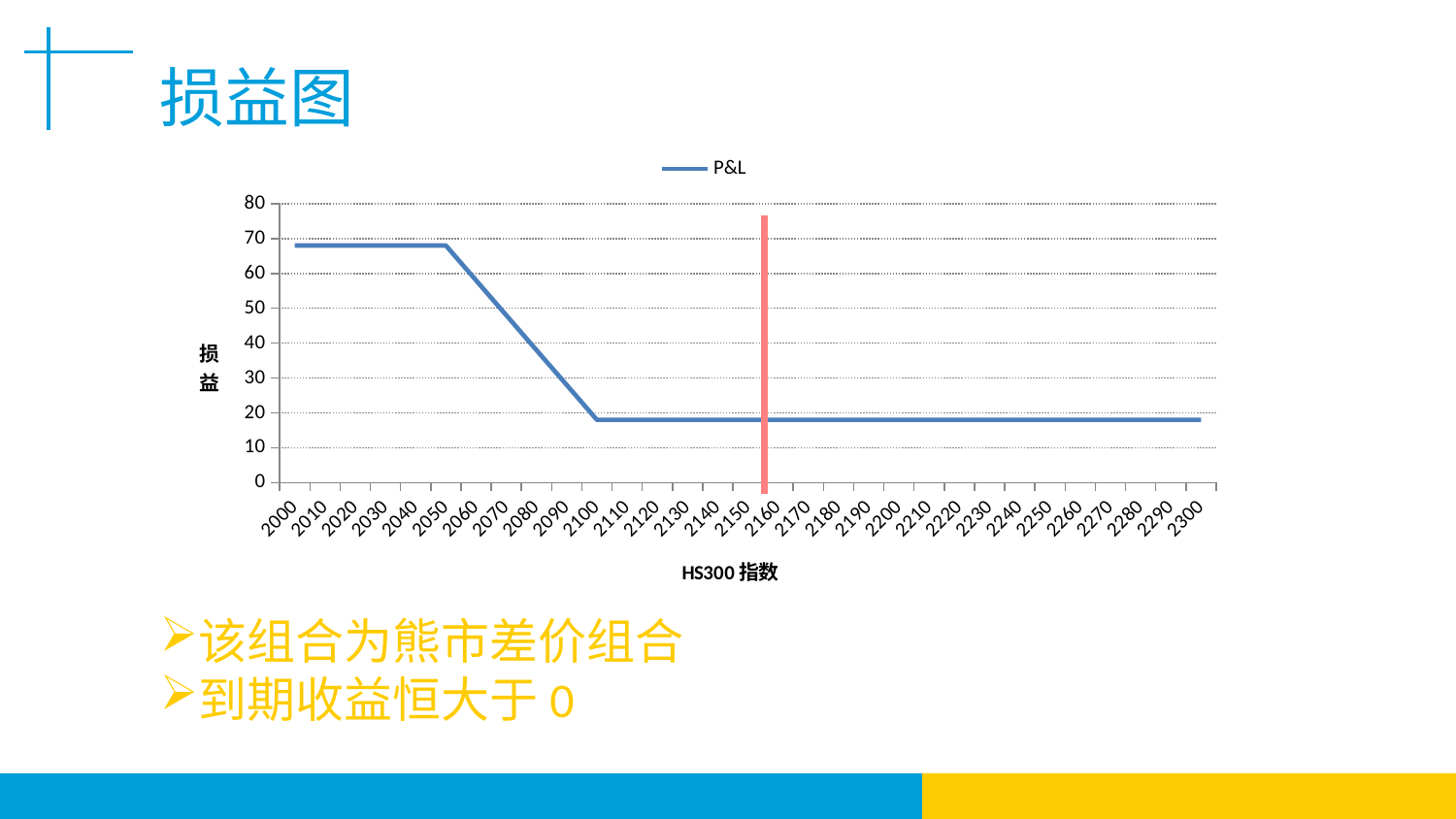
What kind of chart is shown on the slide? line chart Is the P&L value at 2080 greater or less than 20? greater Which has the larger P&L value, 2000 or 2300? 2000 What is the title of the x axis? HS300 指数 How many series does the legend list? 1 What is the name of the series shown in the legend? P&L Is the P&L value at 2050 greater or less than 60? greater How many x-axis tick labels are shown on the chart? 31 Is the P&L value at 2100 greater or less than 30? less Does the P&L line rise or fall overall as the HS300 index increases from 2000 to 2300? fall